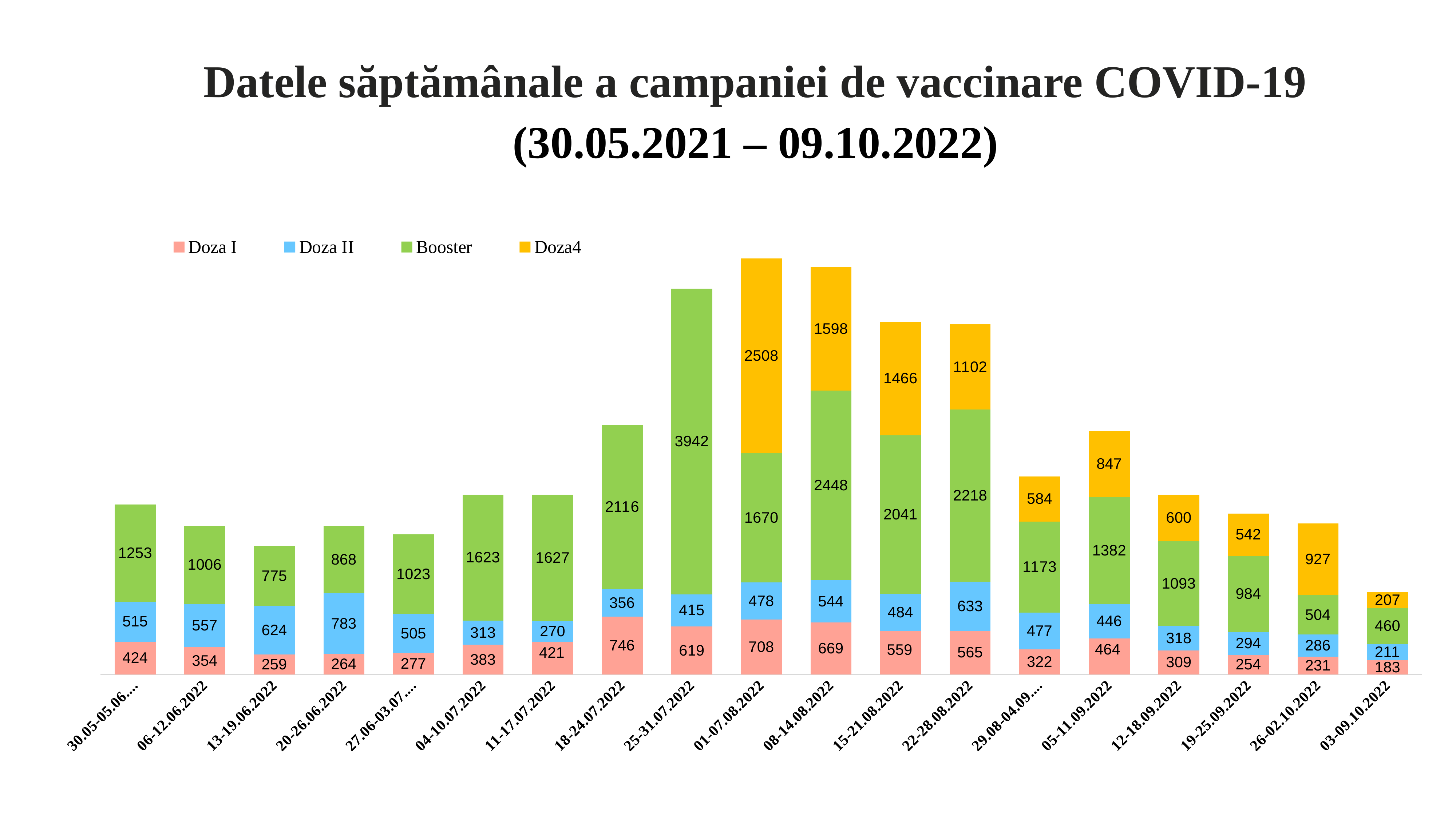
What is the Doza I value for the week 18-24.07.2022? 746 Which week has the lowest Doza I value? 03-09.10.2022 What is the Doza4 value for the week 01-07.08.2022? 2508 Which week has the highest Booster value? 25-31.07.2022 How many weekly categories are shown on the x axis? 19 Which series is shown in yellow in the legend? Doza4 What is the total of the stacked bar for the week 03-09.10.2022? 1061 What is the Booster value for the week 25-31.07.2022? 3942 What is the difference between the Doza4 values for 01-07.08.2022 and 08-14.08.2022? 910 How many series does the legend list? 4 Which is larger, the Doza II value for 20-26.06.2022 or for 04-10.07.2022? 20-26.06.2022 What kind of chart is shown on the slide? stacked bar chart